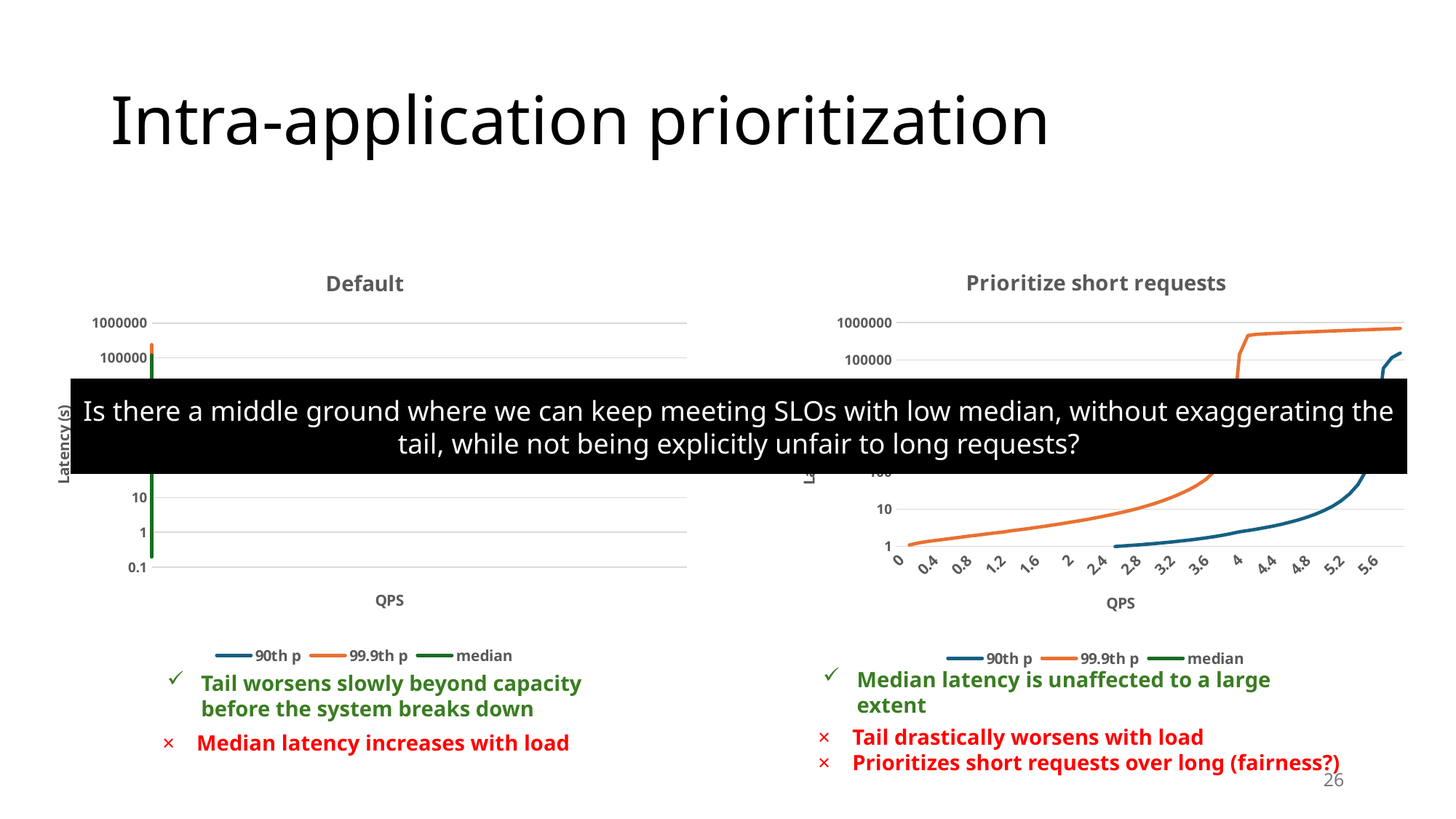
In the "Prioritize short requests" chart, at QPS 4.4, which series has the higher latency, 90th p or 99.9th p? 99.9th p In the "Prioritize short requests" chart, is the 90th p latency at QPS 2.8 greater or less than 10? less What kind of chart is the "Default" chart? line chart In the "Prioritize short requests" chart, does the 99.9th p latency rise or fall as QPS increases? rise How many tick labels are shown on the x axis of the "Prioritize short requests" chart? 15 How many series does the legend of the "Prioritize short requests" chart list? 3 In the "Prioritize short requests" chart, which series is drawn in orange? 99.9th p What is the x-axis label of the "Prioritize short requests" chart? QPS In the "Prioritize short requests" chart, is the 99.9th p latency at QPS 5.6 greater or less than 100000? greater In the "Prioritize short requests" chart, does the 90th p latency rise or fall as QPS increases? rise What kind of chart is the "Prioritize short requests" chart? line chart How many series does the legend of the "Default" chart list? 3